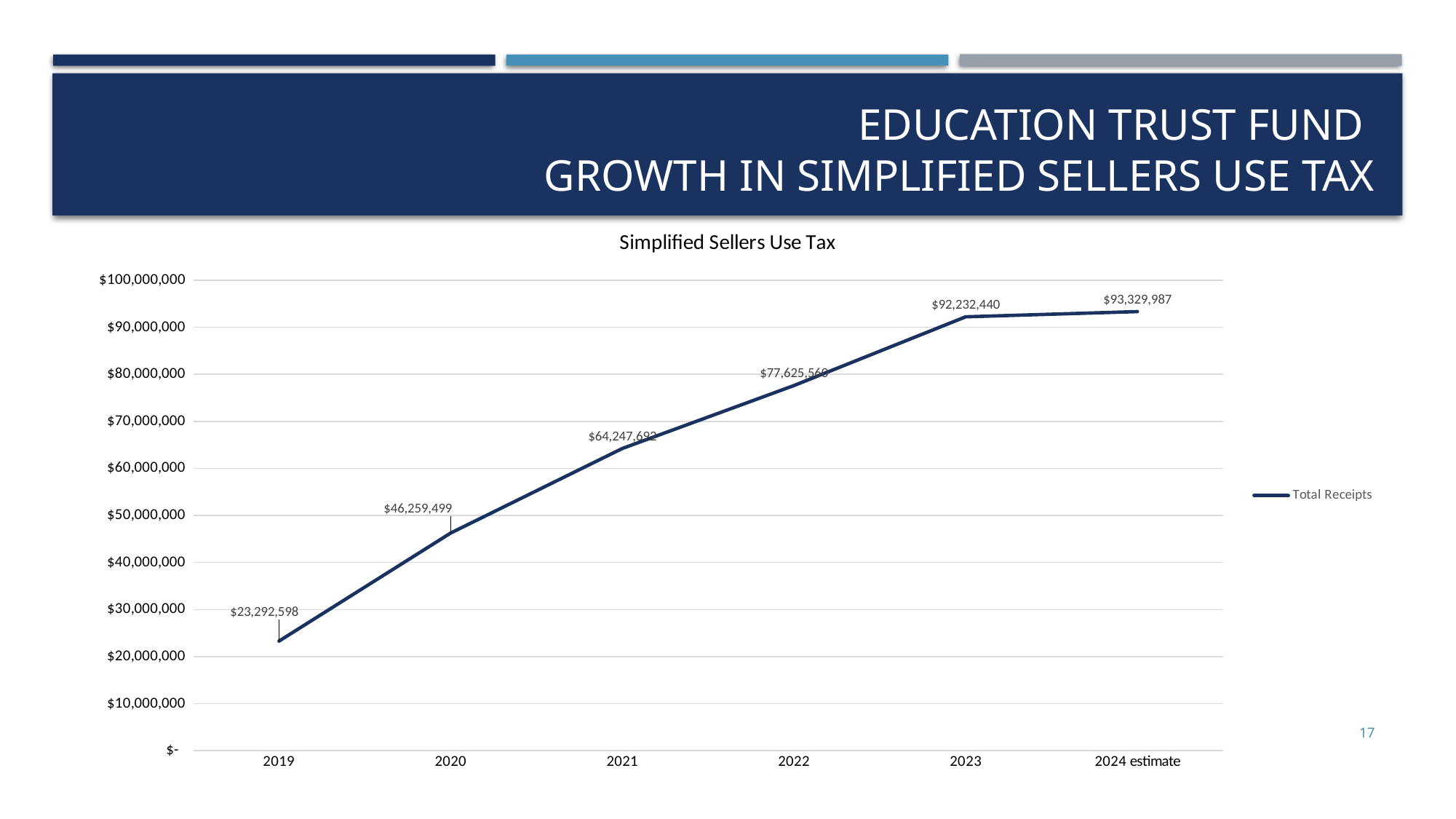
Which point on the x axis has the highest Total Receipts? 2024 estimate What is the value of Total Receipts for the 2024 estimate? $93,329,987 What is the value of Total Receipts for 2019? $23,292,598 What is the value of Total Receipts for 2020? $46,259,499 Do the Total Receipts values rise or fall from 2019 to the 2024 estimate? Rise What is the difference between Total Receipts in 2020 and 2019? $22,966,901 What is the value of Total Receipts for 2023? $92,232,440 Is the value for 2021 greater or less than $70,000,000? less Which year has the lowest Total Receipts? 2019 What kind of chart is shown on the slide? Line chart How many points are plotted along the x axis? 6 Is the value for 2022 greater or less than $70,000,000? greater